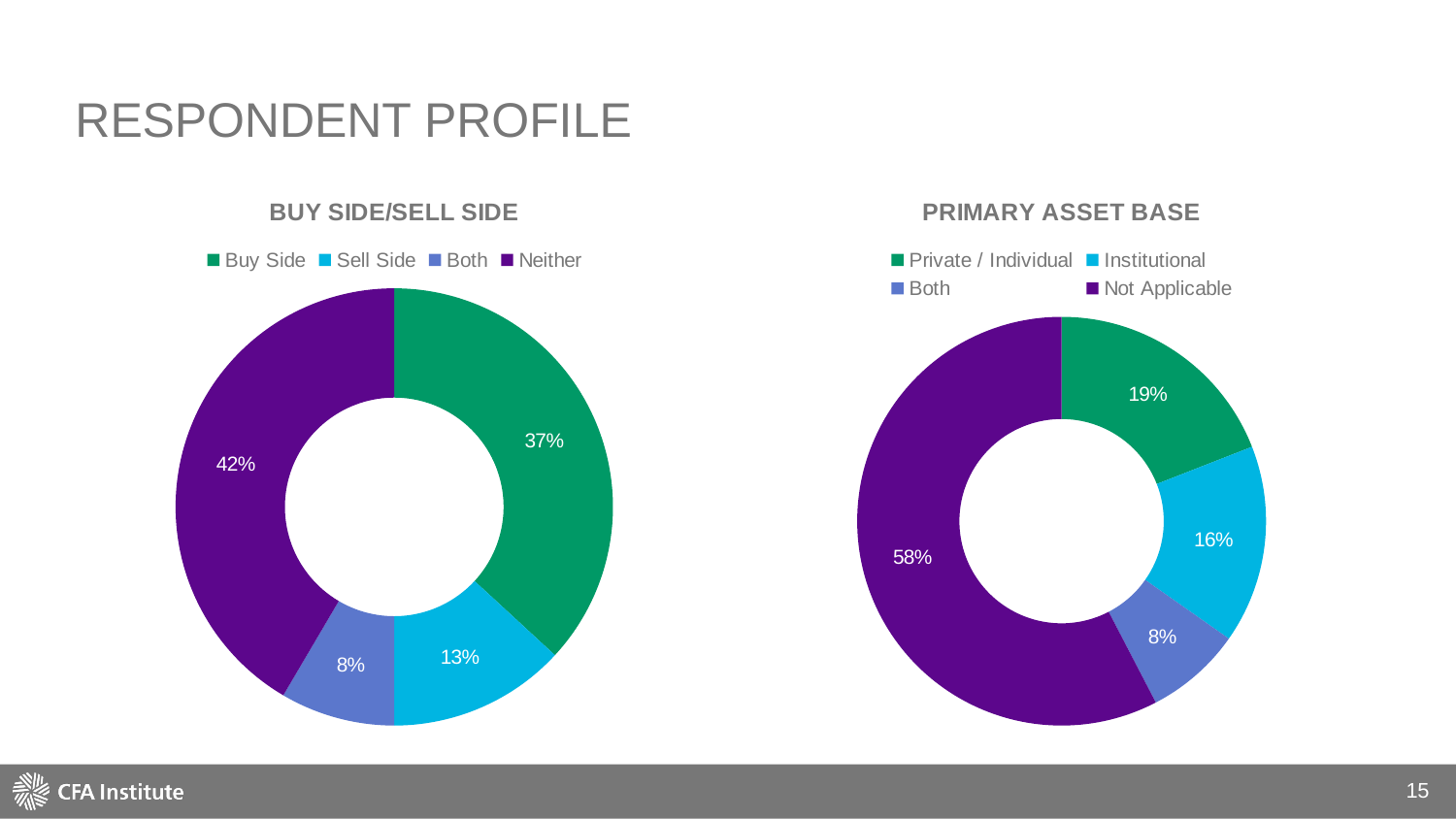
In the BUY SIDE/SELL SIDE chart, which category has the smallest share? Both In the BUY SIDE/SELL SIDE chart, how many categories does the legend list? 4 In the BUY SIDE/SELL SIDE chart, what is the difference between the Buy Side and Sell Side shares? 24% In the PRIMARY ASSET BASE chart, what percentage of respondents are Not Applicable? 58% What type of chart is the PRIMARY ASSET BASE chart? Doughnut chart In the PRIMARY ASSET BASE chart, what percentage of respondents are Institutional? 16% In the BUY SIDE/SELL SIDE chart, which category has the largest share? Neither In the BUY SIDE/SELL SIDE chart, what percentage of respondents are Neither? 42% In the PRIMARY ASSET BASE chart, which is larger, Private / Individual or Institutional? Private / Individual In the PRIMARY ASSET BASE chart, what is the difference between the Not Applicable and Private / Individual shares? 39% What is the title of the chart on the left side of the slide? BUY SIDE/SELL SIDE In the BUY SIDE/SELL SIDE chart, what percentage of respondents are Buy Side? 37%